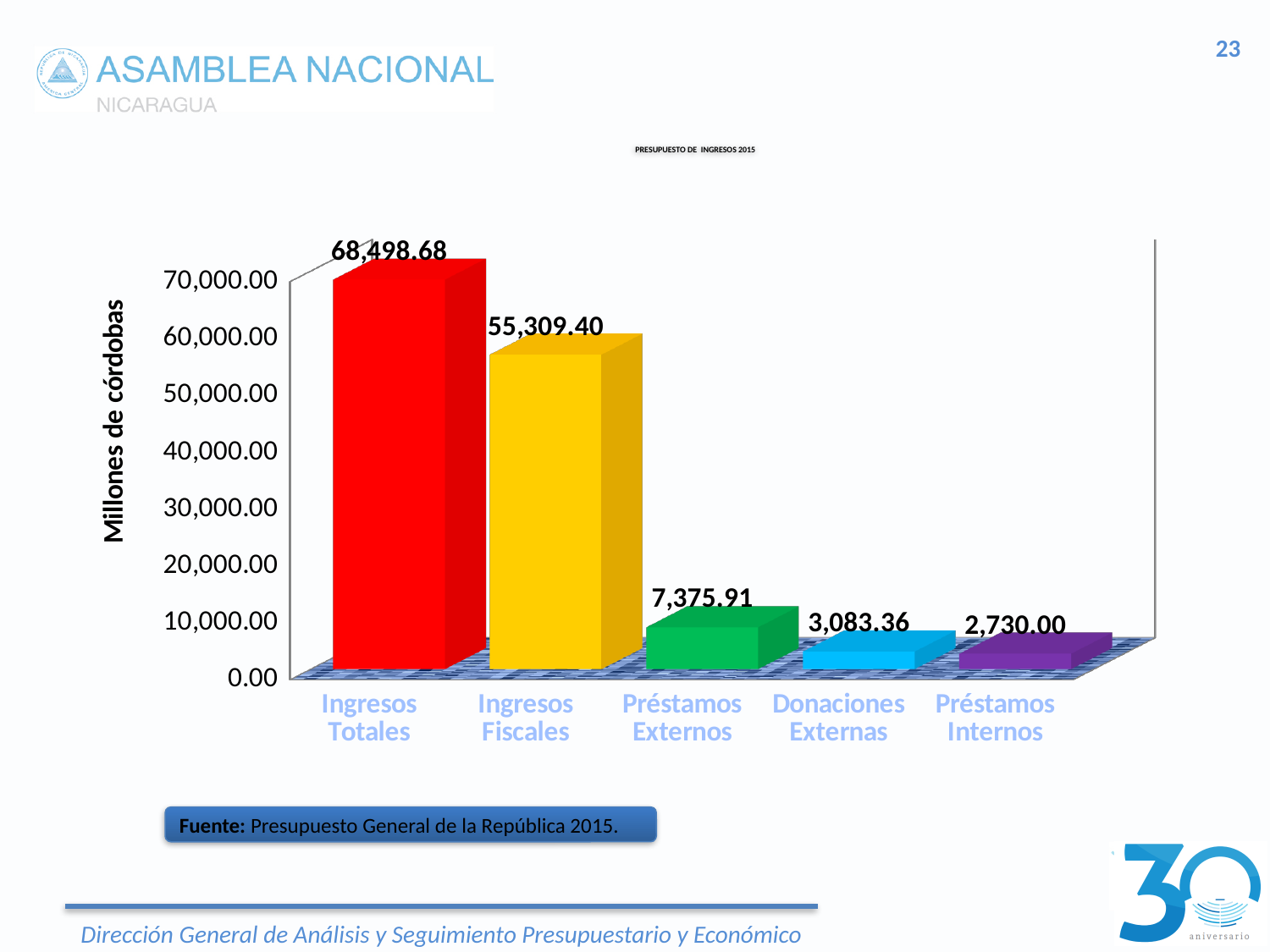
What is the value for Ingresos Totales? 68,498.68 What is the difference between Préstamos Externos and Donaciones Externas? 4,292.55 What is the value for Donaciones Externas? 3,083.36 Which category has the highest value? Ingresos Totales How many categories are shown in the chart? 5 What is the label of the vertical axis? Millones de córdobas Which is larger, Donaciones Externas or Préstamos Internos? Donaciones Externas What is the value for Préstamos Externos? 7,375.91 What is the difference between Ingresos Totales and Ingresos Fiscales? 13,189.28 Which category has the lowest value? Préstamos Internos What kind of chart is shown? Bar chart What is the value for Ingresos Fiscales? 55,309.40